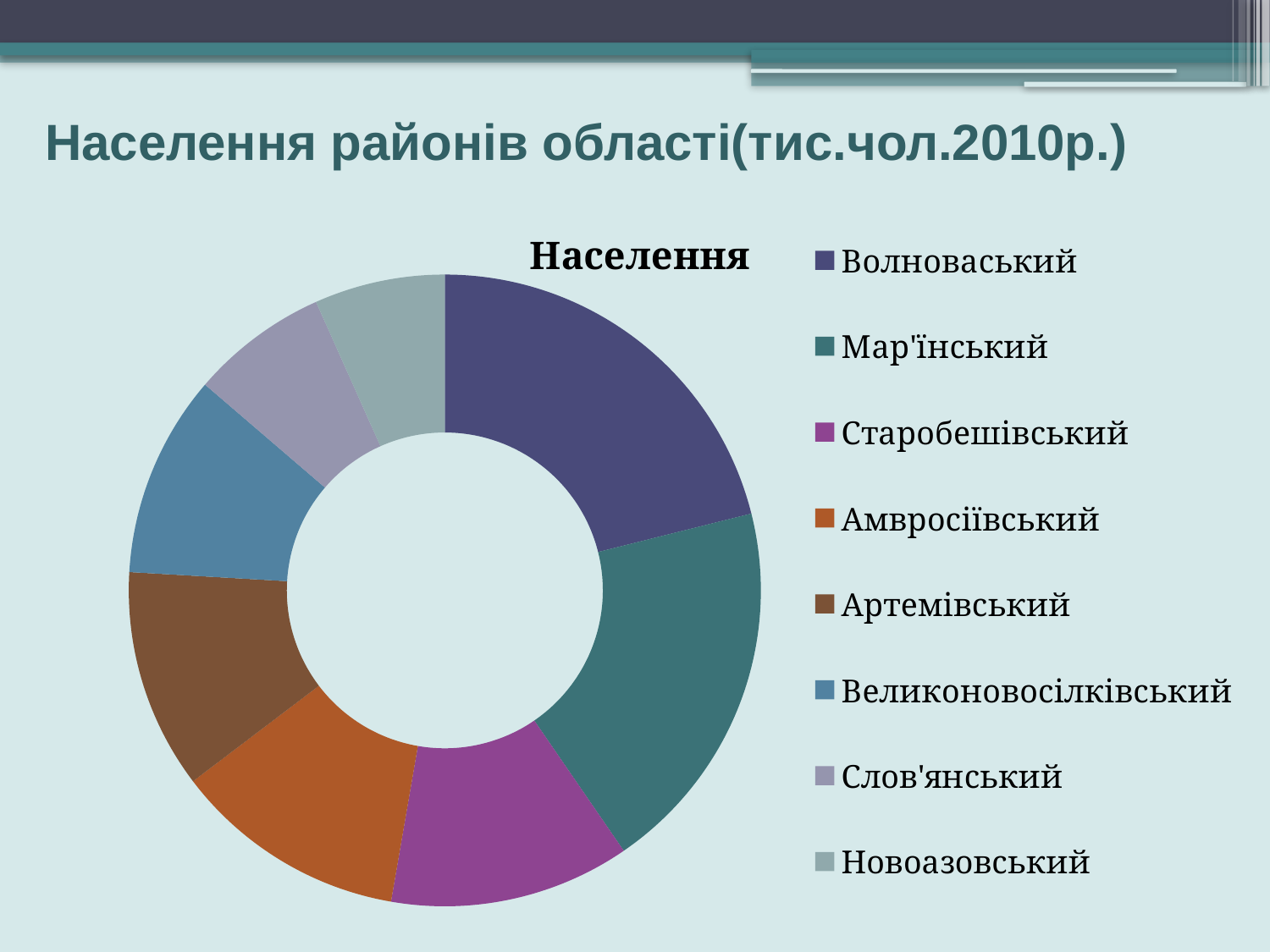
Which has the larger share of the chart, Волноваський or Новоазовський? Волноваський Which has the larger share of the chart, Мар'їнський or Артемівський? Мар'їнський What kind of chart is shown on the slide? Doughnut (pie) chart How many districts (categories) does the chart show? 8 Which has the larger share of the chart, Амвросіївський or Слов'янський? Амвросіївський What is the title of the chart? Населення Which district is listed first in the legend? Волноваський